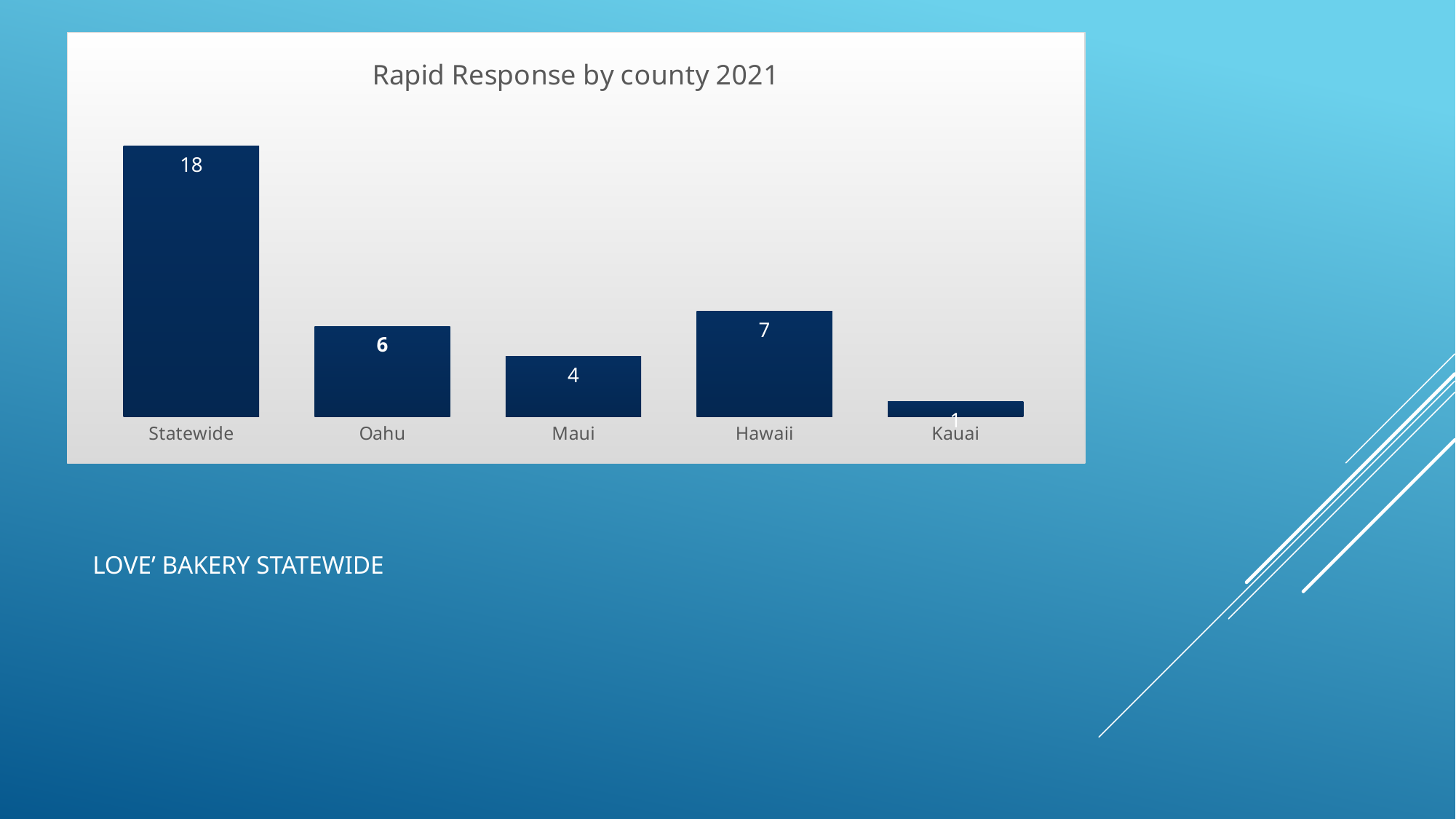
Which category has the lowest value? Kauai Which category has the highest value? Statewide What kind of chart is this? Bar chart What is the value for Statewide? 18 Which has a larger value, Oahu or Hawaii? Hawaii What is the value for Oahu? 6 What is the value for Kauai? 1 How many categories are shown on the x axis? 5 What is the title of the chart? Rapid Response by county 2021 What is the value for Hawaii? 7 What is the value for Maui? 4 What is the difference between the values for Hawaii and Maui? 3